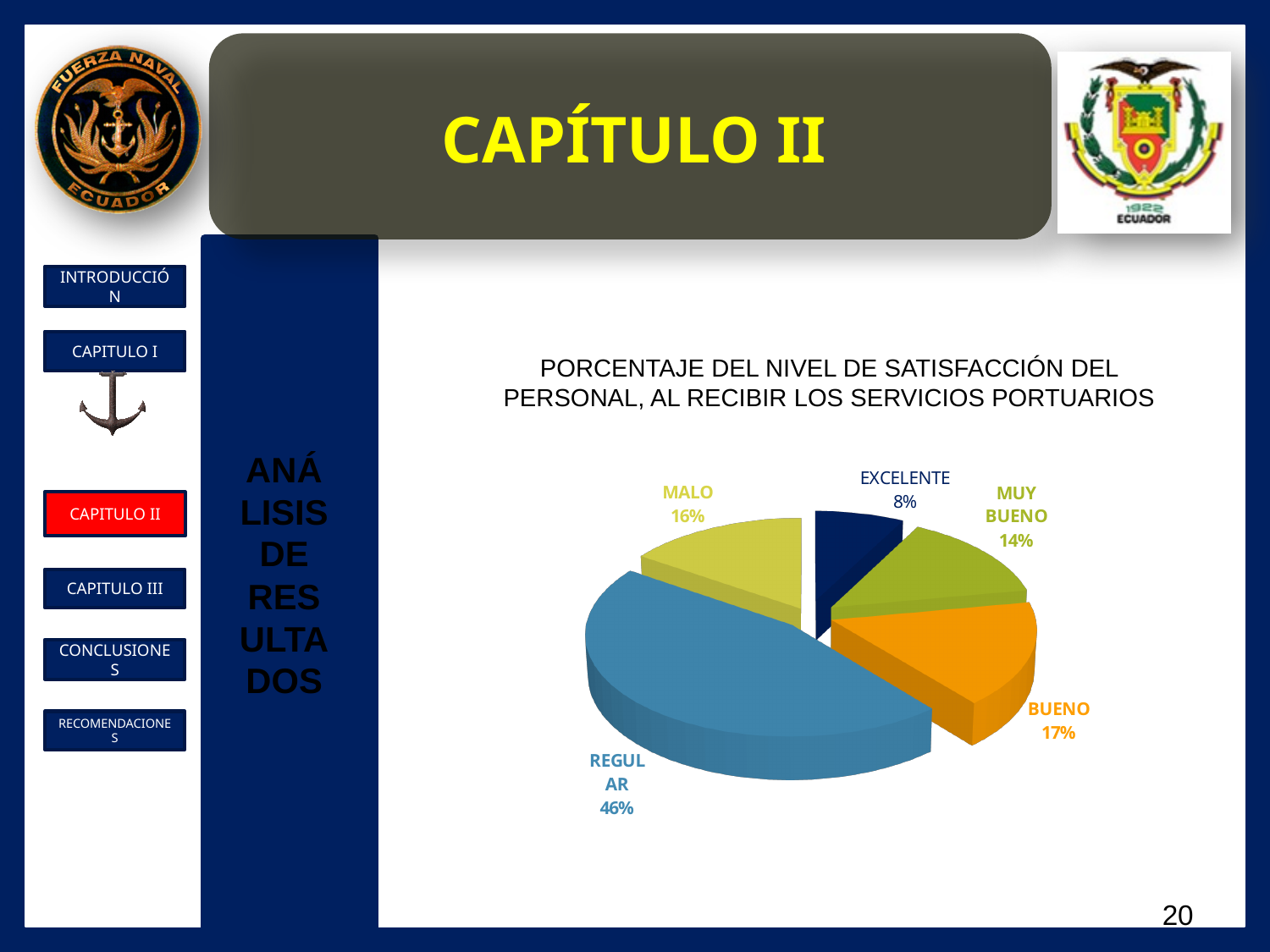
What percentage is shown for BUENO? 17% What kind of chart is shown on the slide? Pie chart What percentage is shown for REGULAR? 46% Which category has the smallest share of the pie? EXCELENTE What percentage is shown for MALO? 16% Which category has the largest share of the pie? REGULAR Which is larger, the share for MALO or the share for MUY BUENO? MALO What is the difference in percentage points between REGULAR and BUENO? 29 What is the title of the chart? PORCENTAJE DEL NIVEL DE SATISFACCIÓN DEL PERSONAL, AL RECIBIR LOS SERVICIOS PORTUARIOS What percentage is shown for EXCELENTE? 8% How many categories does the pie chart show? 5 What percentage is shown for MUY BUENO? 14%